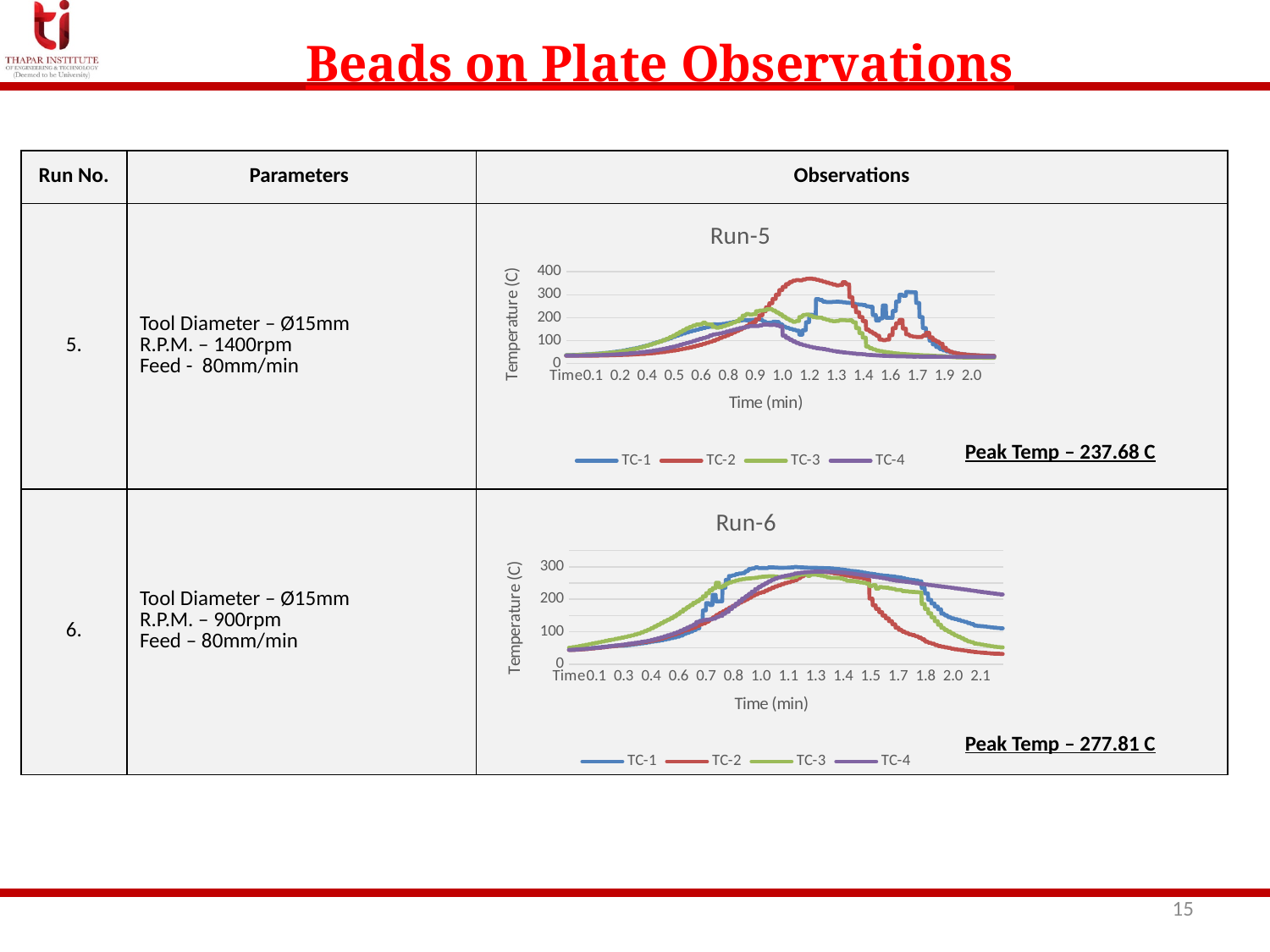
In the Run-6 chart, does TC-1 rise or fall between 0.1 min and 1.1 min? rise What kind of chart is the Run-5 chart? line chart How many series does the legend of the Run-6 chart list? 4 In the Run-5 chart, is the peak value of TC-2 greater or less than 300? greater In the Run-6 chart, which series ends at the lowest temperature at 2.1 min? TC-2 In the Run-5 chart, does TC-4 rise or fall between 1.0 min and 2.0 min? fall What is the label of the y-axis on the Run-6 chart? Temperature (C) What is the title of the top chart on the slide? Run-5 In the Run-5 chart, is the peak value of TC-3 greater or less than 200? greater In the Run-5 chart, which series has the lowest peak temperature? TC-4 In the Run-5 chart, which series reaches the highest temperature? TC-2 In the Run-6 chart, is the final value of TC-2 at 2.1 min greater or less than 100? less